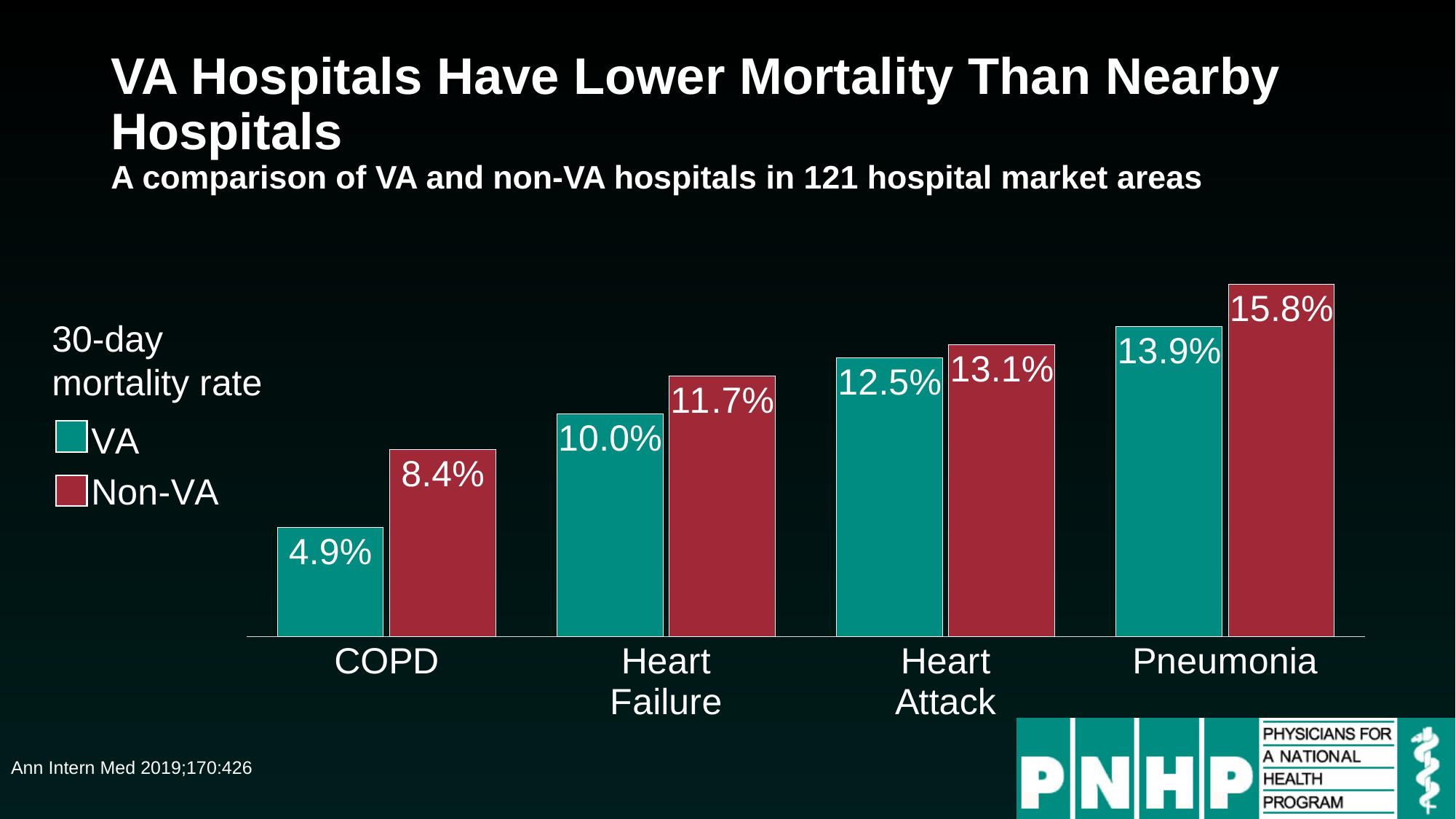
What kind of chart is shown on the slide? Bar chart For Heart Failure, which is higher: the VA or the Non-VA mortality rate? Non-VA What is the difference between the Non-VA and VA mortality rates for COPD? 3.5% What is the difference between the Non-VA and VA mortality rates for Pneumonia? 1.9% Which condition has the lowest VA 30-day mortality rate? COPD What is the 30-day mortality rate for VA hospitals for Heart Attack? 12.5% Which condition has the highest Non-VA 30-day mortality rate? Pneumonia What is the 30-day mortality rate for Non-VA hospitals for Pneumonia? 15.8% What is the 30-day mortality rate for Non-VA hospitals for Heart Failure? 11.7% What is the 30-day mortality rate for VA hospitals for COPD? 4.9% How many series does the legend list? 2 How many conditions are shown on the x axis? 4